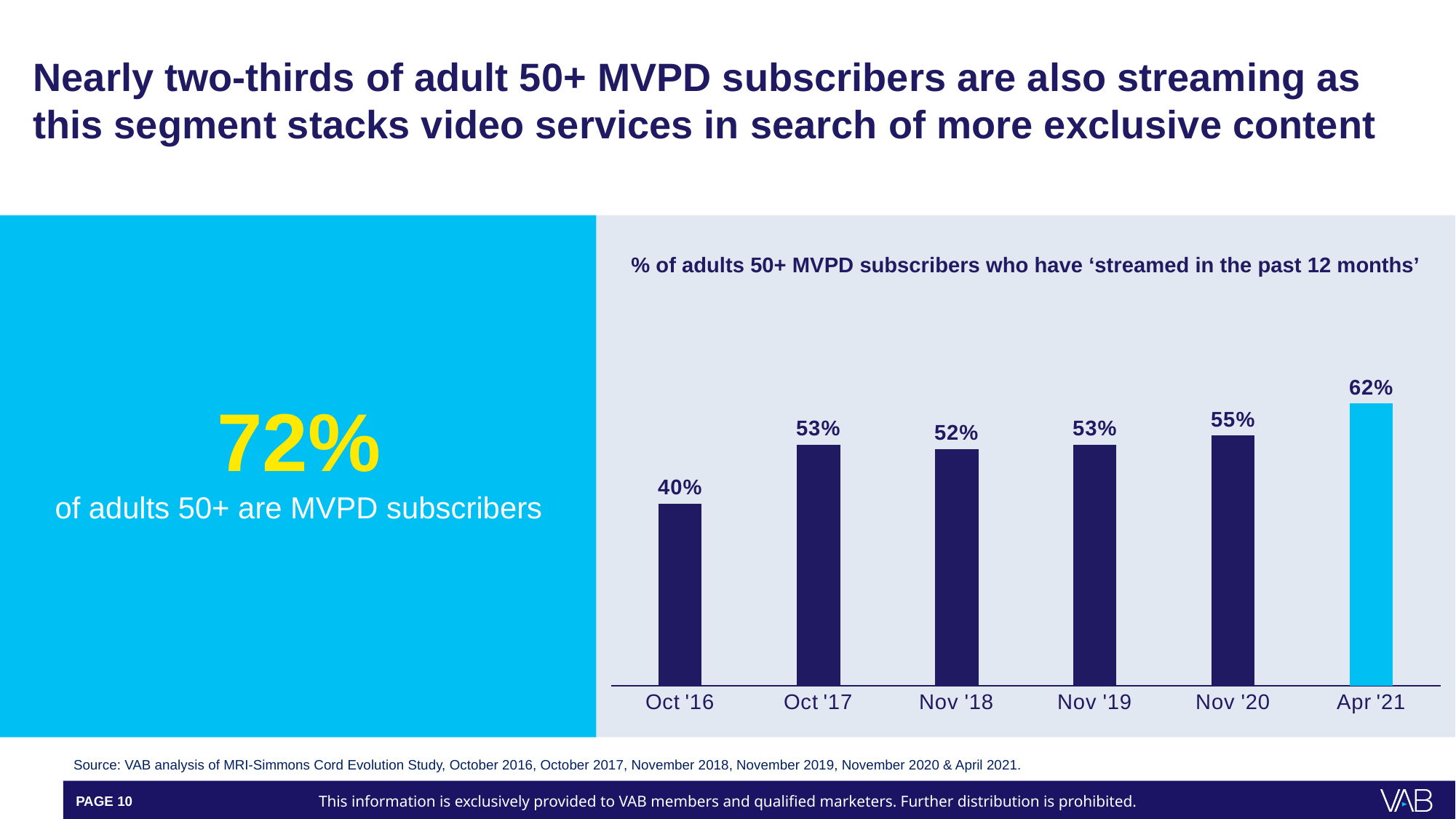
Which is larger, the value for Oct '17 or the value for Oct '16? Oct '17 What is the value for Apr '21? 62% What is the value for Nov '20? 55% What is the value for Oct '16? 40% What is the title of the chart? % of adults 50+ MVPD subscribers who have 'streamed in the past 12 months' How many periods are shown on the x axis? 6 Which period has the lowest value? Oct '16 What kind of chart is shown? Bar chart Which period has the highest value? Apr '21 What is the difference between the values for Nov '20 and Nov '19? 2% What is the value for Nov '18? 52% What is the difference between the values for Apr '21 and Oct '16? 22%